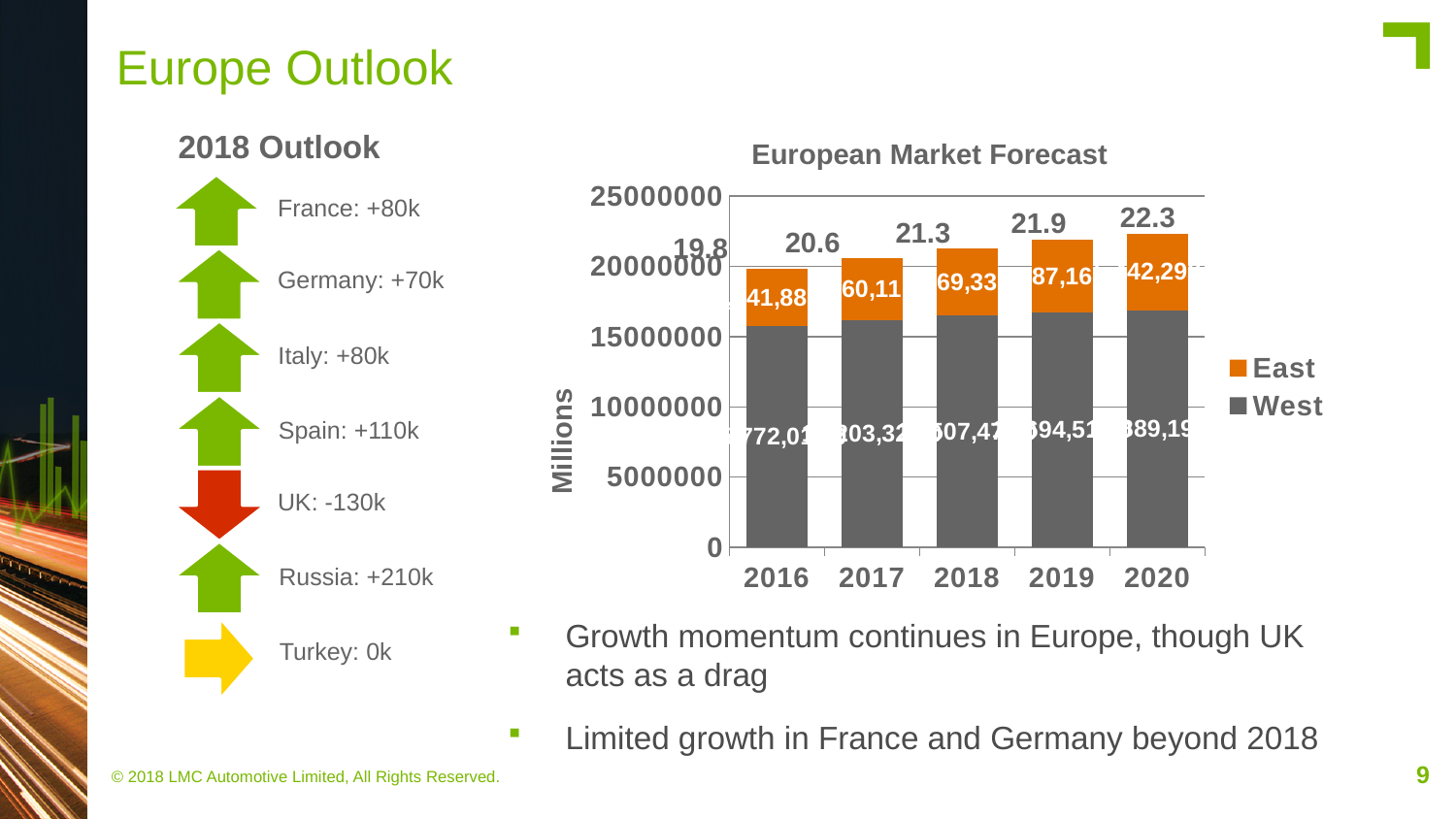
How many series does the legend of the European Market Forecast chart list? 2 In the European Market Forecast chart, is the West value for 2020 greater or less than 15000000? greater What total value is labelled above the 2020 bar in the European Market Forecast chart? 22.3 Do the total values in the European Market Forecast chart rise or fall from 2016 to 2020? rise Which year has the lowest total in the European Market Forecast chart? 2016 What kind of chart is the European Market Forecast chart? stacked bar chart What is the difference between the labelled totals for 2020 and 2016 in the European Market Forecast chart? 2.5 What are the two legend entries in the European Market Forecast chart? East and West What total value is labelled above the 2018 bar in the European Market Forecast chart? 21.3 What total value is labelled above the 2016 bar in the European Market Forecast chart? 19.8 How many years are shown on the x axis of the European Market Forecast chart? 5 Which year has the highest total in the European Market Forecast chart? 2020